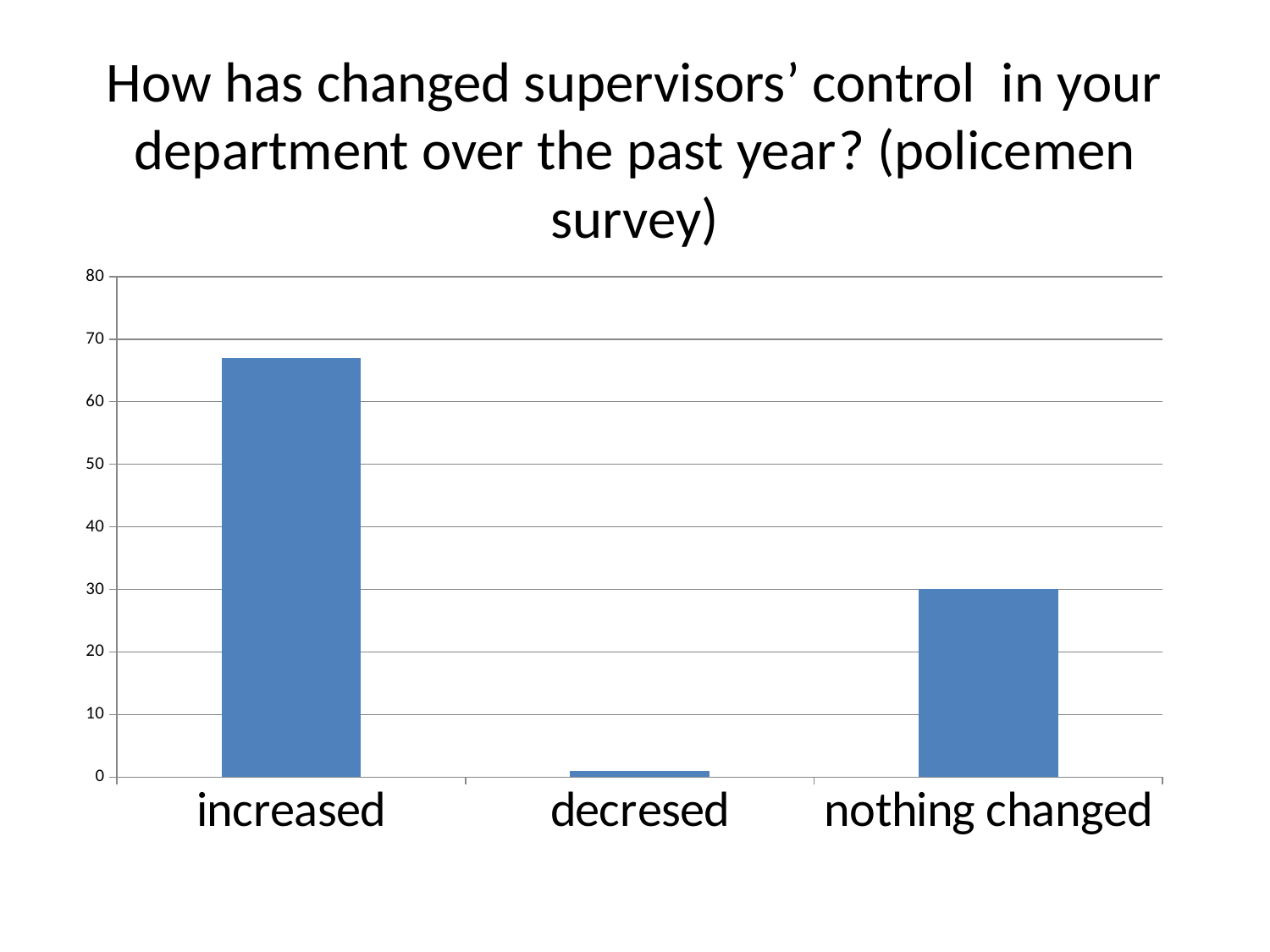
Which is larger, the value for "decresed" or the value for "nothing changed"? nothing changed What is the highest value shown on the vertical axis of the chart? 80 Is the value for "decresed" greater or less than 10? less What is the value for "nothing changed"? 30 According to the slide title, which group was surveyed for this chart? policemen Which is larger, the value for "increased" or the value for "nothing changed"? increased Which category has the lowest value in the chart? decresed Is the value for "increased" greater or less than 70? less Is the value for "increased" greater or less than 60? greater How many categories are shown on the x axis of the chart? 3 Which category has the highest value in the chart? increased What kind of chart is shown on the slide? bar chart